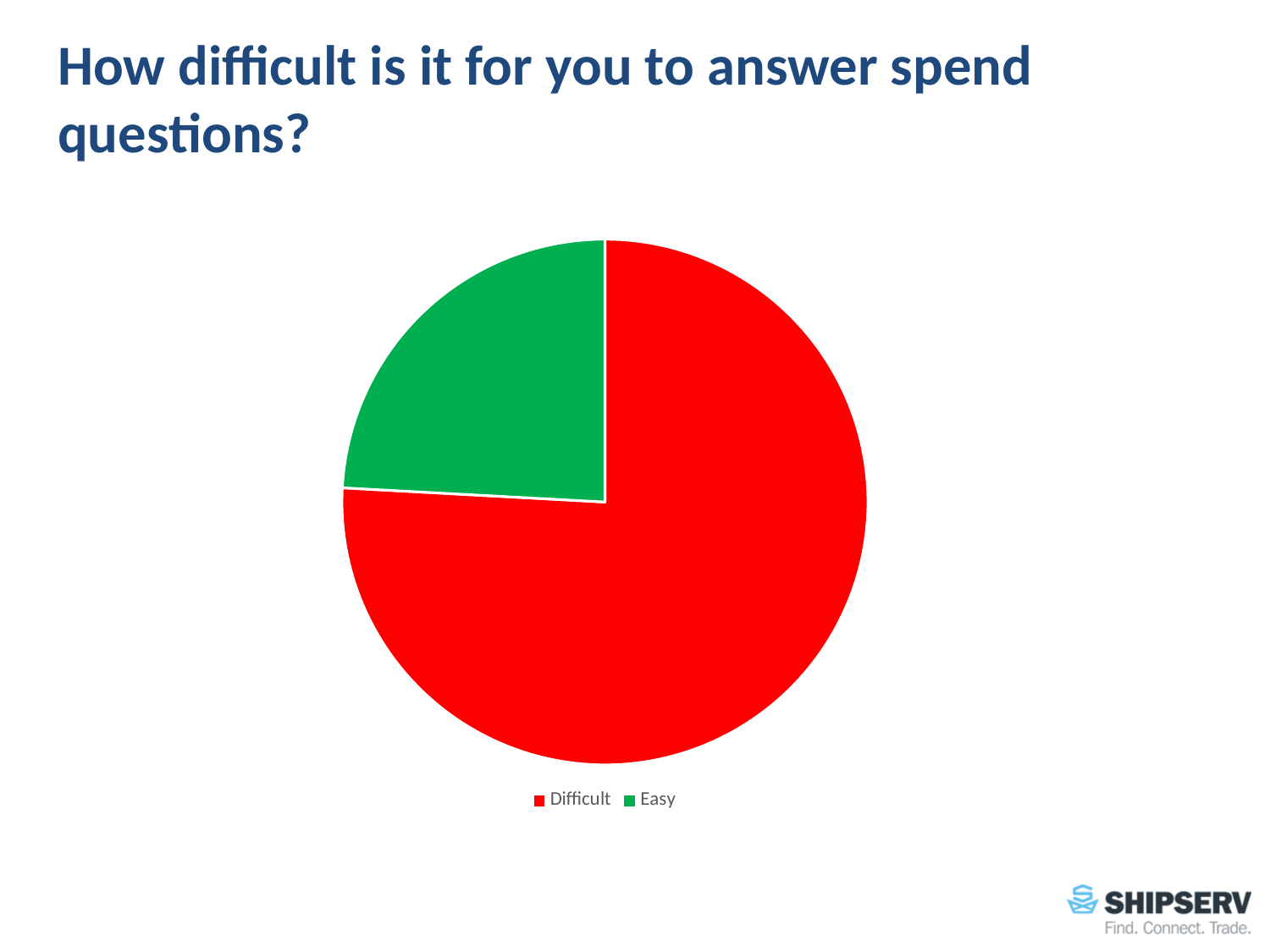
Which category has the smallest slice of the pie? Easy How many entries does the legend list? 2 Which category has the largest slice of the pie? Difficult Which slice is larger, Difficult or Easy? Difficult What colour is the Difficult slice? red Is the Difficult slice greater or less than half of the pie? greater How many slices does the pie chart have? 2 What colour is the Easy slice? green What kind of chart is shown on the slide? pie chart Is the Easy slice greater or less than half of the pie? less